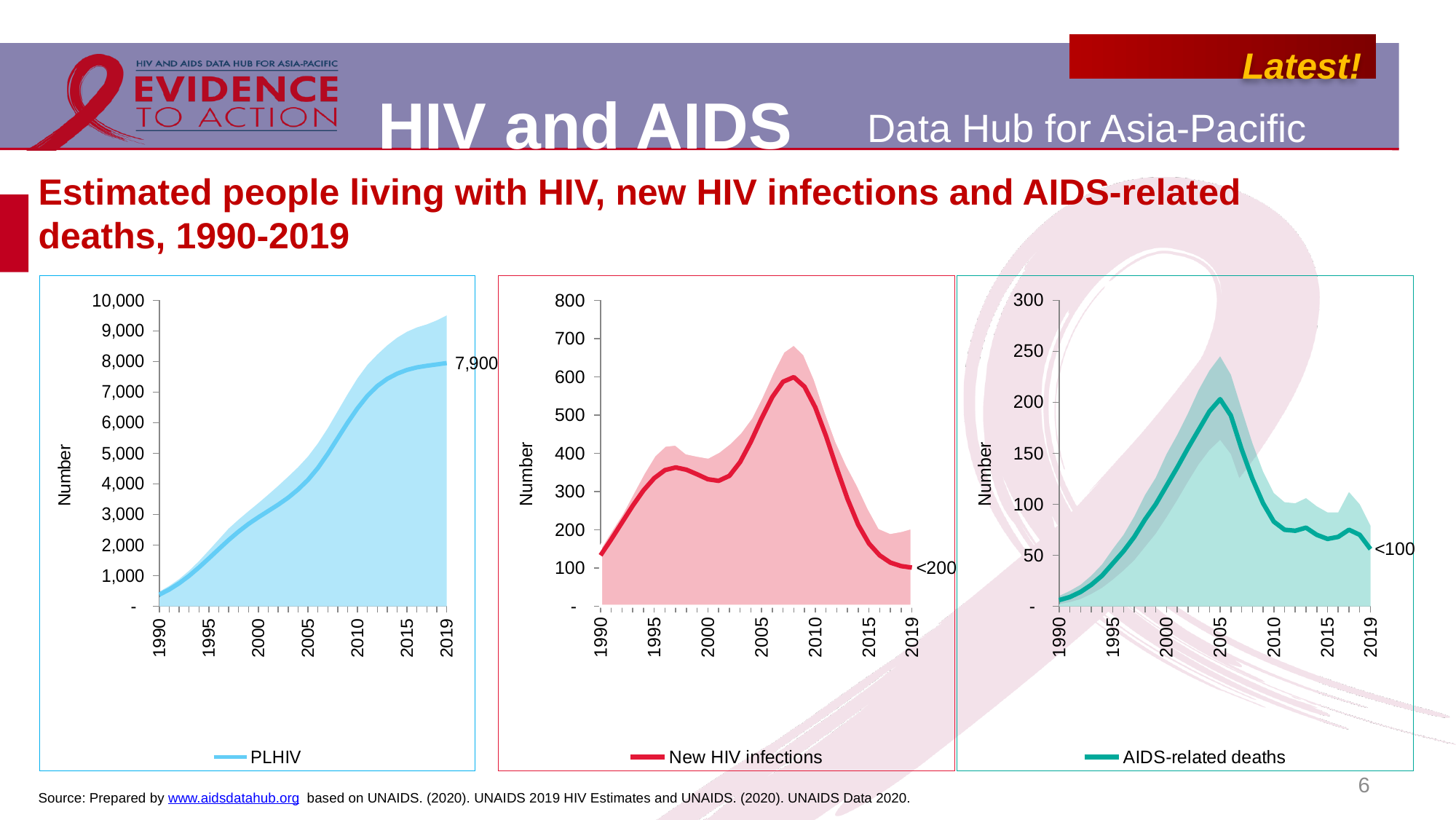
In the PLHIV chart, what is the labelled value for 2019? 7,900 What is the legend entry of the leftmost chart? PLHIV In the PLHIV chart, is the value for 1990 greater or less than 1,000? less What kind of chart is the PLHIV chart? Combination area and line chart (a line with a shaded area band) In the PLHIV chart, do the values rise or fall from 1990 to 2019? Rise In the AIDS-related deaths chart, in which year does the line reach its highest point? 2005 How many series does the legend of the New HIV infections chart list? 1 In the New HIV infections chart, what is the labelled value for 2019? <200 In the New HIV infections chart, is the peak value greater or less than 500? greater In the New HIV infections chart, is the value for 1990 greater or less than 200? less In the AIDS-related deaths chart, what is the labelled value for 2019? <100